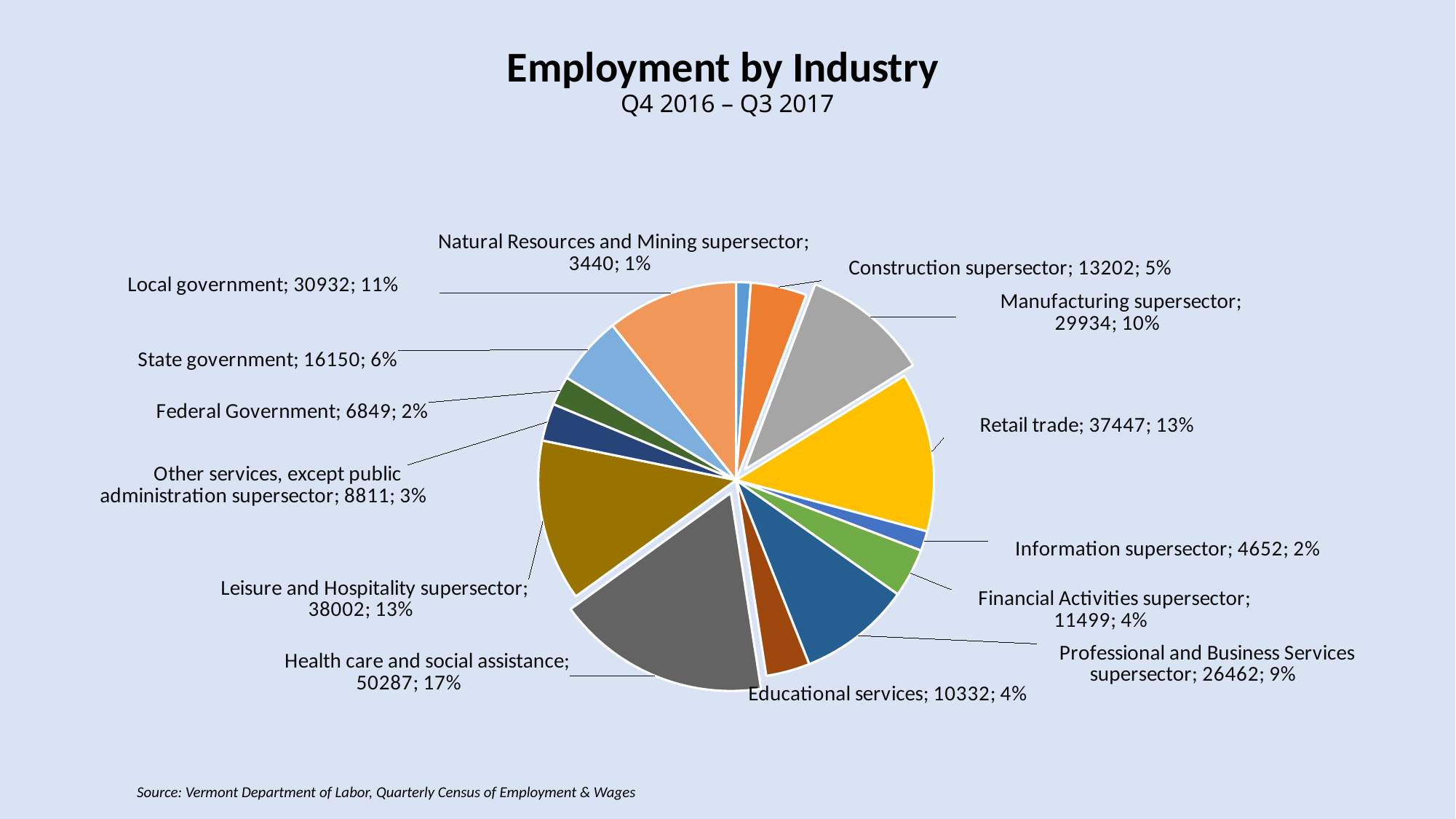
Which has higher employment, Local government or State government? Local government What type of chart is shown on the slide? Pie chart What share of the pie does the Manufacturing supersector represent? 10% How many industry categories are shown in the pie chart? 14 Which industry has the smallest employment in the chart? Natural Resources and Mining supersector What is the employment value for Retail trade? 37447 What is the difference in employment between Retail trade and the Manufacturing supersector? 7513 What is the employment value for Local government? 30932 Which industry has the largest employment in the chart? Health care and social assistance What is the difference in employment between Local government and State government? 14782 What is the title of the chart? Employment by Industry What share of the pie does Health care and social assistance represent? 17%